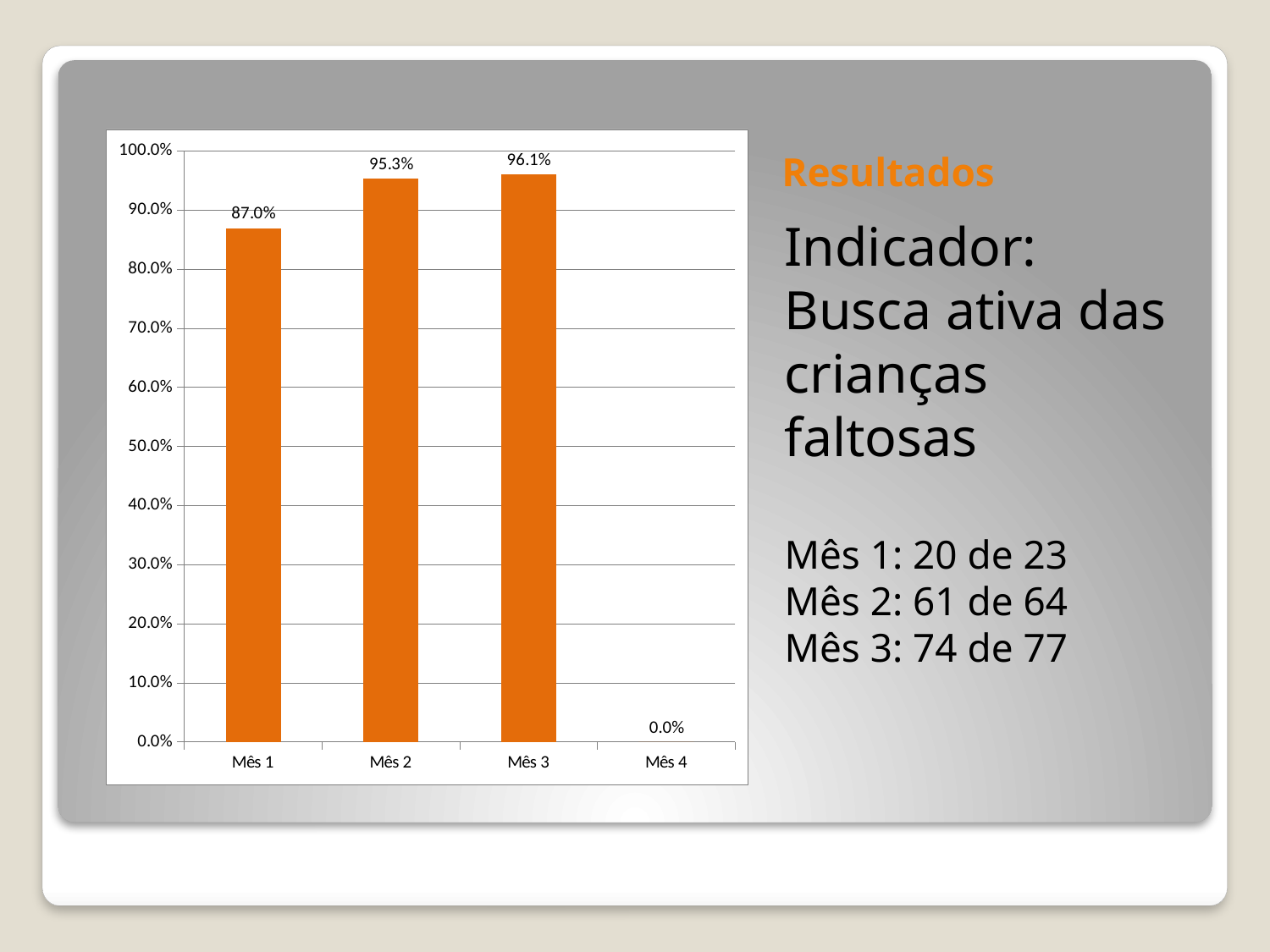
Which month has the highest value? Mês 3 Which is larger, the value for Mês 1 or the value for Mês 2? Mês 2 Is the value for Mês 1 greater or less than 80.0%? greater What kind of chart is shown on the slide? bar chart What is the value for Mês 1? 87.0% What colour are the bars in the chart? orange What is the value for Mês 4? 0.0% What is the value for Mês 3? 96.1% How many categories are shown on the x axis? 4 What is the difference between the values for Mês 2 and Mês 1? 8.3% Which month has the lowest value? Mês 4 What is the value for Mês 2? 95.3%